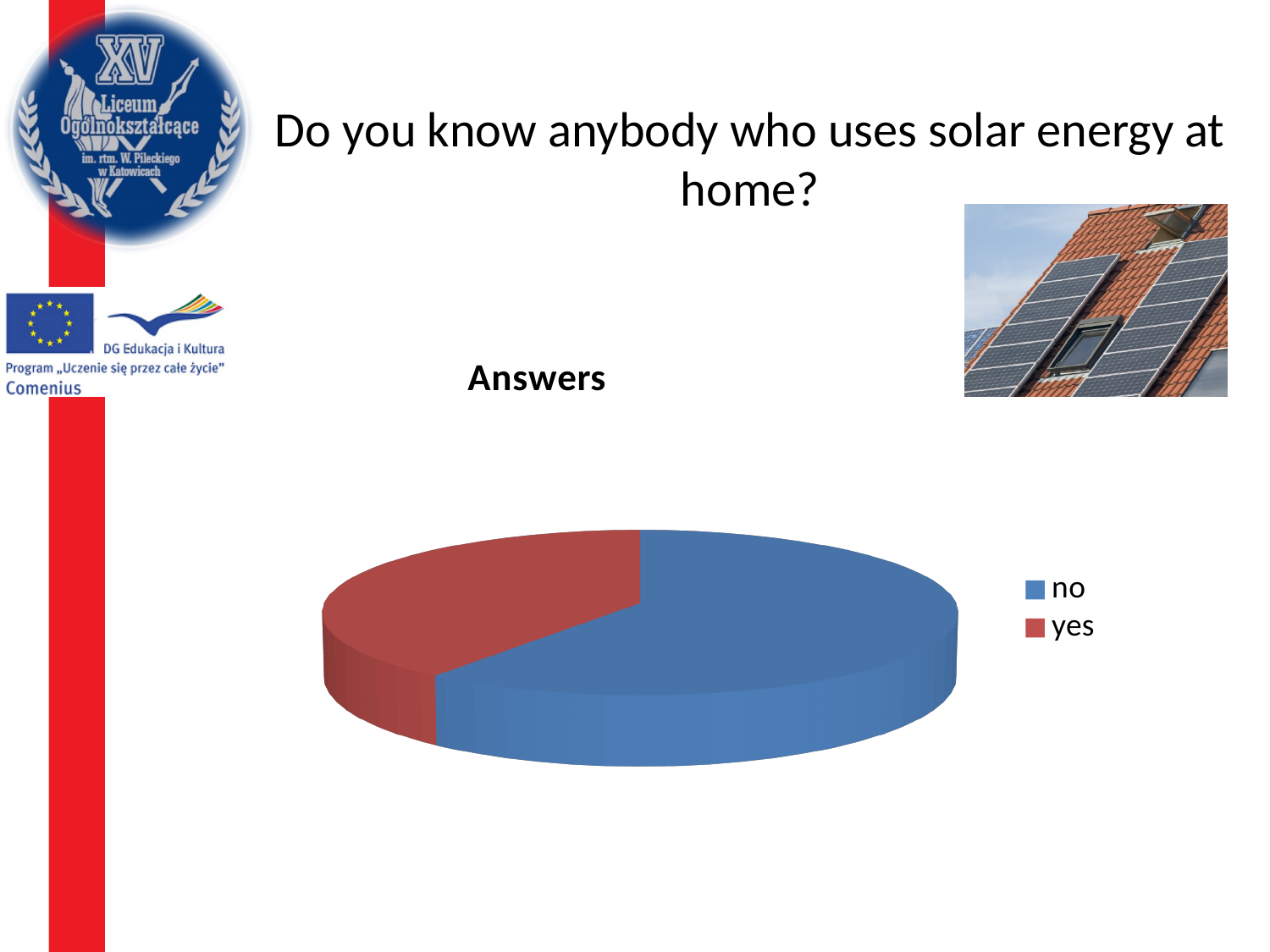
Which answer has the smallest slice of the pie? yes What is the title of the chart? Answers What kind of chart is shown on the slide? pie chart What colour is the "yes" slice? red How many slices does the pie chart have? 2 How many entries does the legend list? 2 Which slice is larger, "no" or "yes"? no Which answer has the largest slice of the pie? no